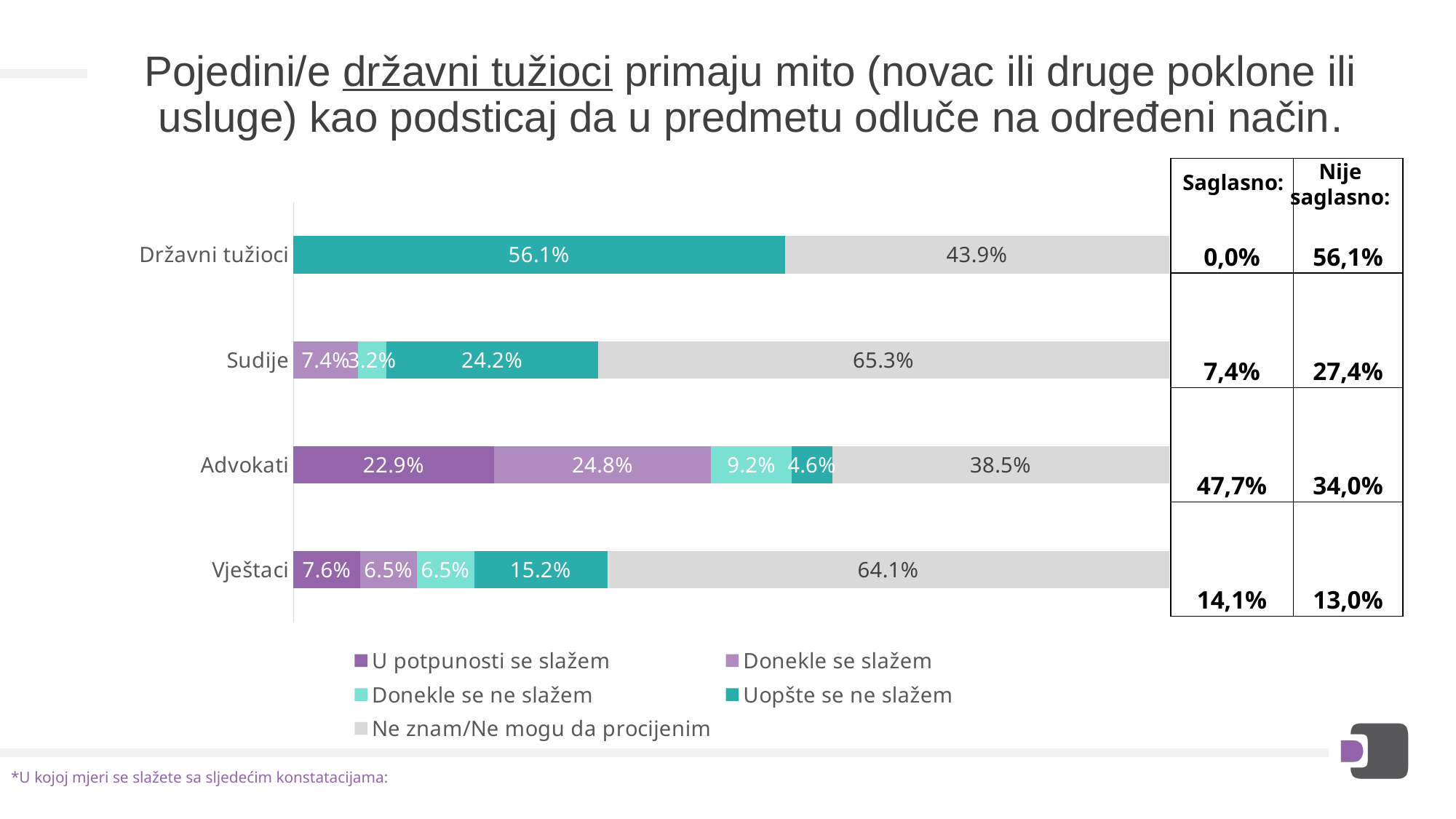
How many respondent groups (categories) are shown on the chart? 4 What is the value of 'Ne znam/Ne mogu da procijenim' for Sudije? 65.3% What is the value of 'Ne znam/Ne mogu da procijenim' for Vještaci? 64.1% What is the total of the two segments in the Državni tužioci bar? 100% What kind of chart is shown on the slide? Stacked bar chart Which group has the highest 'Ne znam/Ne mogu da procijenim' value? Sudije Which group has the lowest 'Ne znam/Ne mogu da procijenim' value? Advokati What is the value of 'U potpunosti se slažem' for Advokati? 22.9% Which group has a larger 'Uopšte se ne slažem' value, Sudije or Vještaci? Sudije For Advokati, what is the difference between 'Donekle se slažem' and 'U potpunosti se slažem'? 1.9 percentage points What is the value of 'Uopšte se ne slažem' for Državni tužioci? 56.1% How many series does the chart legend list? 5